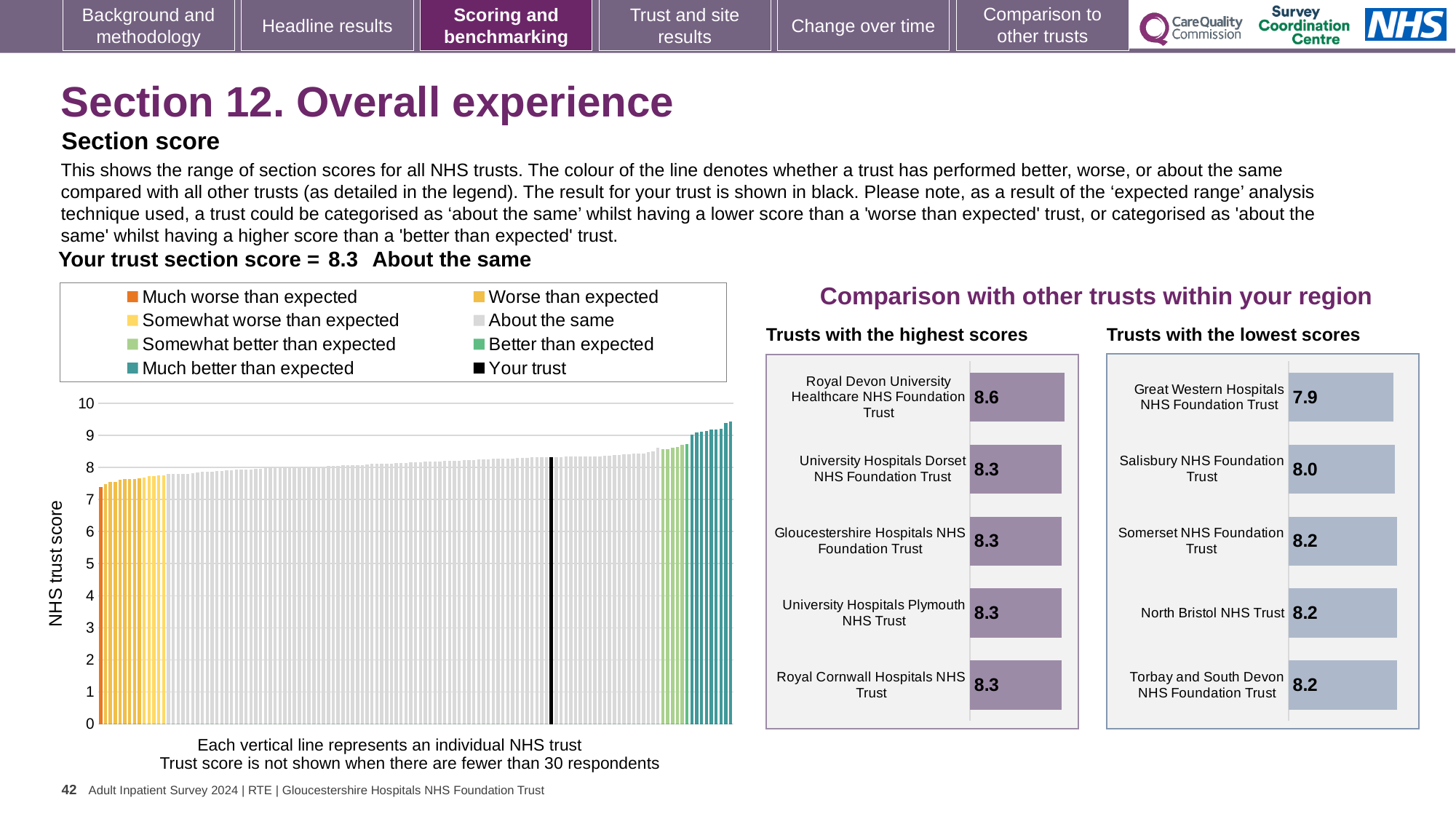
In the main NHS trust score chart on the left, do the values rise or fall from left to right along the x axis? Rise In the 'Trusts with the highest scores' chart, what is the difference between the scores of Royal Devon University Healthcare NHS Foundation Trust and University Hospitals Dorset NHS Foundation Trust? 0.3 What kind of chart is the main chart showing NHS trust scores on the left of the slide? Bar chart What is the label on the vertical axis of the main chart on the left of the slide? NHS trust score In the 'Trusts with the highest scores' chart, what is the score for Royal Devon University Healthcare NHS Foundation Trust? 8.6 How many entries does the legend of the main NHS trust score chart list? 8 In the 'Trusts with the lowest scores' chart, which trust has the lowest score? Great Western Hospitals NHS Foundation Trust In the 'Trusts with the lowest scores' chart, what is the score for Great Western Hospitals NHS Foundation Trust? 7.9 In the 'Trusts with the lowest scores' chart, what is the score for Salisbury NHS Foundation Trust? 8.0 In the 'Trusts with the highest scores' chart, which trust has the highest score? Royal Devon University Healthcare NHS Foundation Trust In the 'Trusts with the lowest scores' chart, which has the larger score: Great Western Hospitals NHS Foundation Trust or Somerset NHS Foundation Trust? Somerset NHS Foundation Trust How many trusts are shown in the 'Trusts with the highest scores' chart? 5